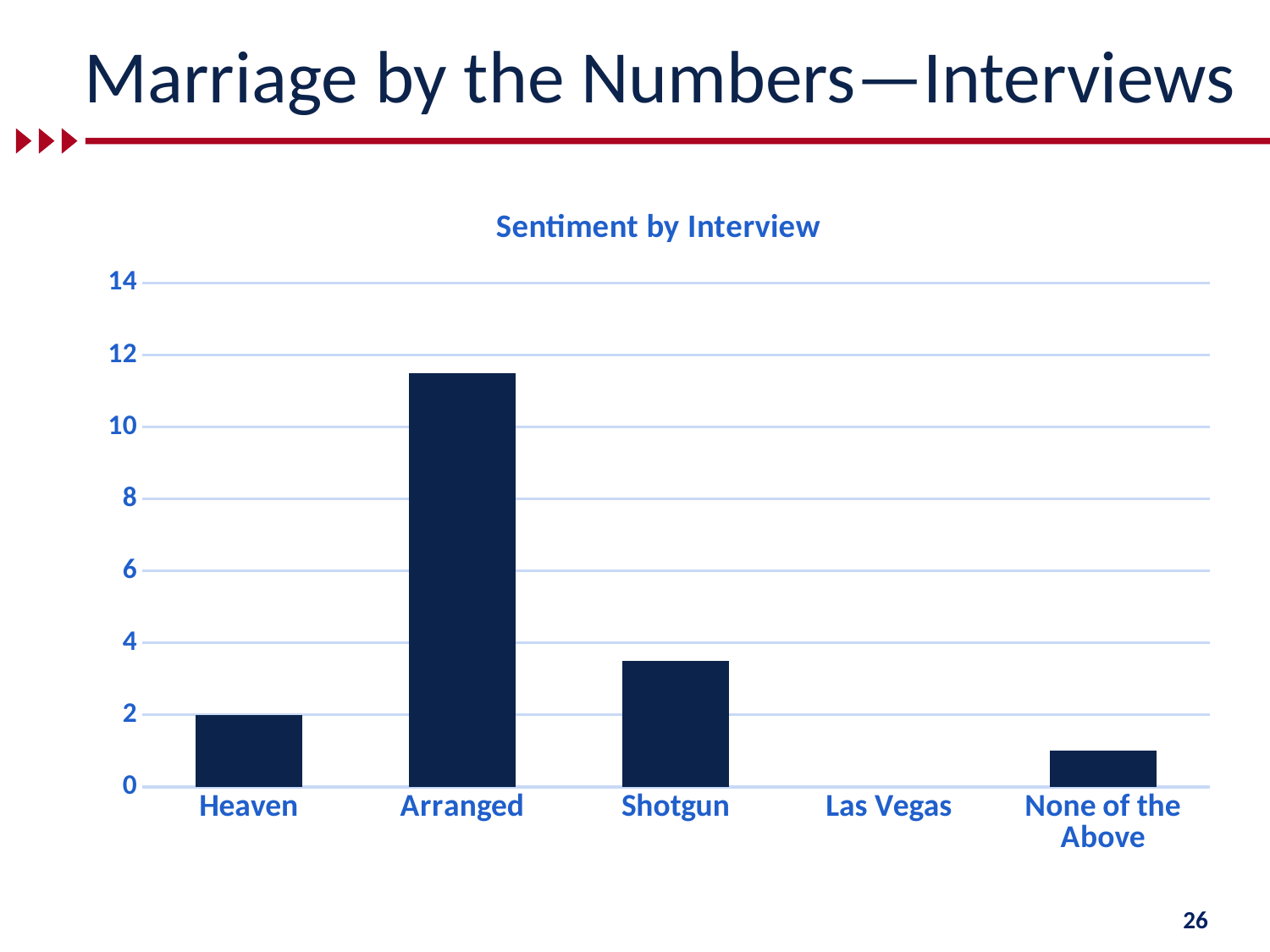
Is the value for Arranged greater or less than 10? greater Which category has the lowest value in the chart? Las Vegas What kind of chart is shown on the slide? bar chart How many categories are shown on the x axis of the chart? 5 What is the title of the chart? Sentiment by Interview Is the value for Shotgun greater or less than 4? less What is the value for Las Vegas? 0 Which category has the highest value in the chart? Arranged Is the value for None of the Above greater or less than 2? less Which is larger, the value for Shotgun or the value for Heaven? Shotgun What is the value for Heaven? 2 Which is larger, the value for Heaven or the value for None of the Above? Heaven